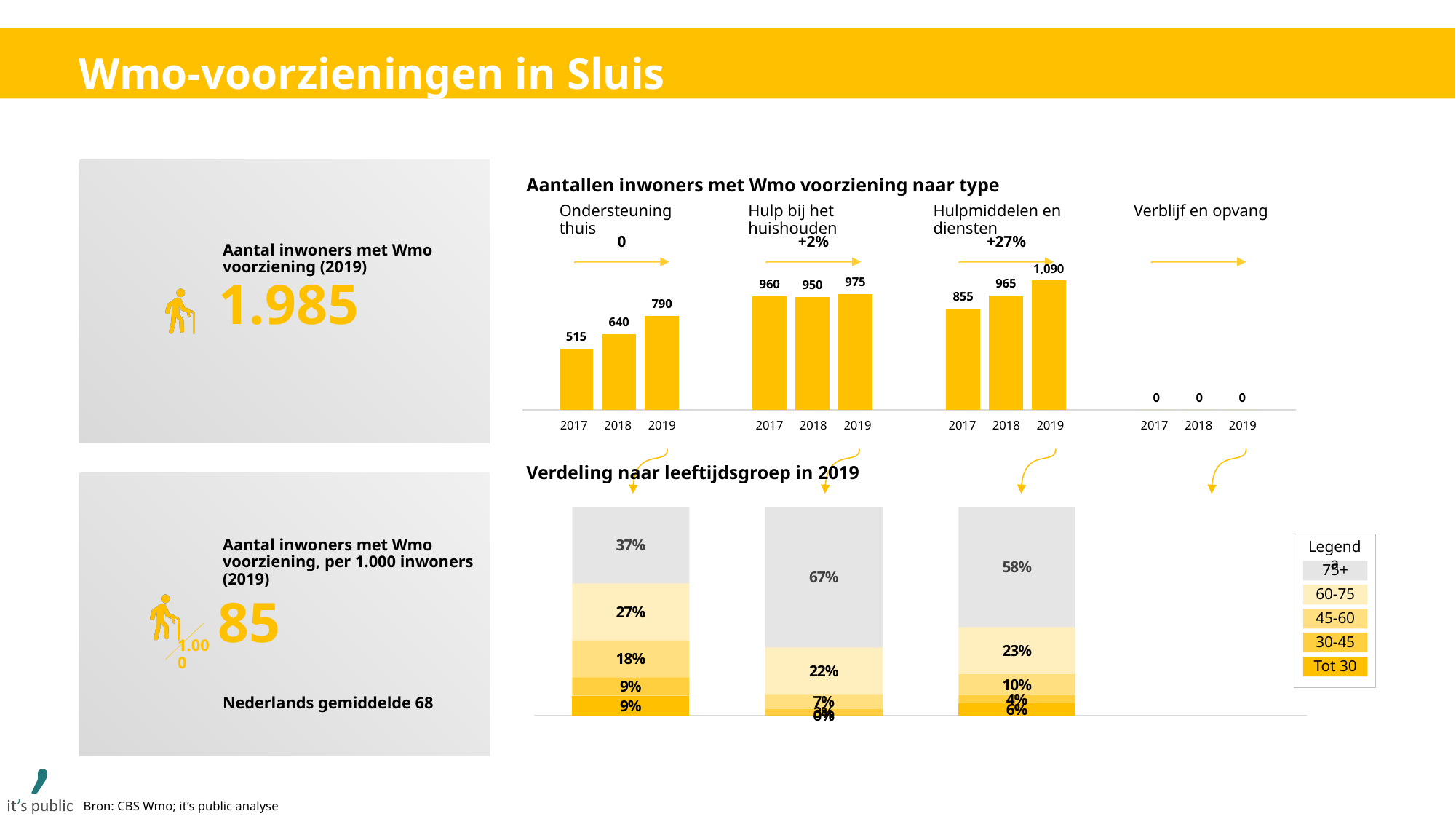
In the chart 'Verdeling naar leeftijdsgroep in 2019', what share of the Ondersteuning thuis bar is the 75+ age group? 37% In the chart 'Aantallen inwoners met Wmo voorziening naar type', what is the value for Verblijf en opvang in 2018? 0 In the chart 'Aantallen inwoners met Wmo voorziening naar type', which is larger: Hulp bij het huishouden in 2019 or Hulpmiddelen en diensten in 2019? Hulpmiddelen en diensten in 2019 In the chart 'Aantallen inwoners met Wmo voorziening naar type', what percentage change is shown above Hulpmiddelen en diensten? +27% In the chart 'Aantallen inwoners met Wmo voorziening naar type', what is the difference between the 2019 and 2017 values for Ondersteuning thuis? 275 In the chart 'Aantallen inwoners met Wmo voorziening naar type', what is the value for Ondersteuning thuis in 2019? 790 In the chart 'Aantallen inwoners met Wmo voorziening naar type', which year has the lowest value for Ondersteuning thuis? 2017 In the chart 'Aantallen inwoners met Wmo voorziening naar type', do the values for Hulpmiddelen en diensten rise or fall from 2017 to 2019? rise In the chart 'Verdeling naar leeftijdsgroep in 2019', what share of the Hulpmiddelen en diensten bar is the 60-75 age group? 23% In the chart 'Aantallen inwoners met Wmo voorziening naar type', what is the value for Hulpmiddelen en diensten in 2019? 1,090 How many age groups does the legend of the chart 'Verdeling naar leeftijdsgroep in 2019' list? 5 In the chart 'Aantallen inwoners met Wmo voorziening naar type', what is the value for Hulp bij het huishouden in 2018? 950